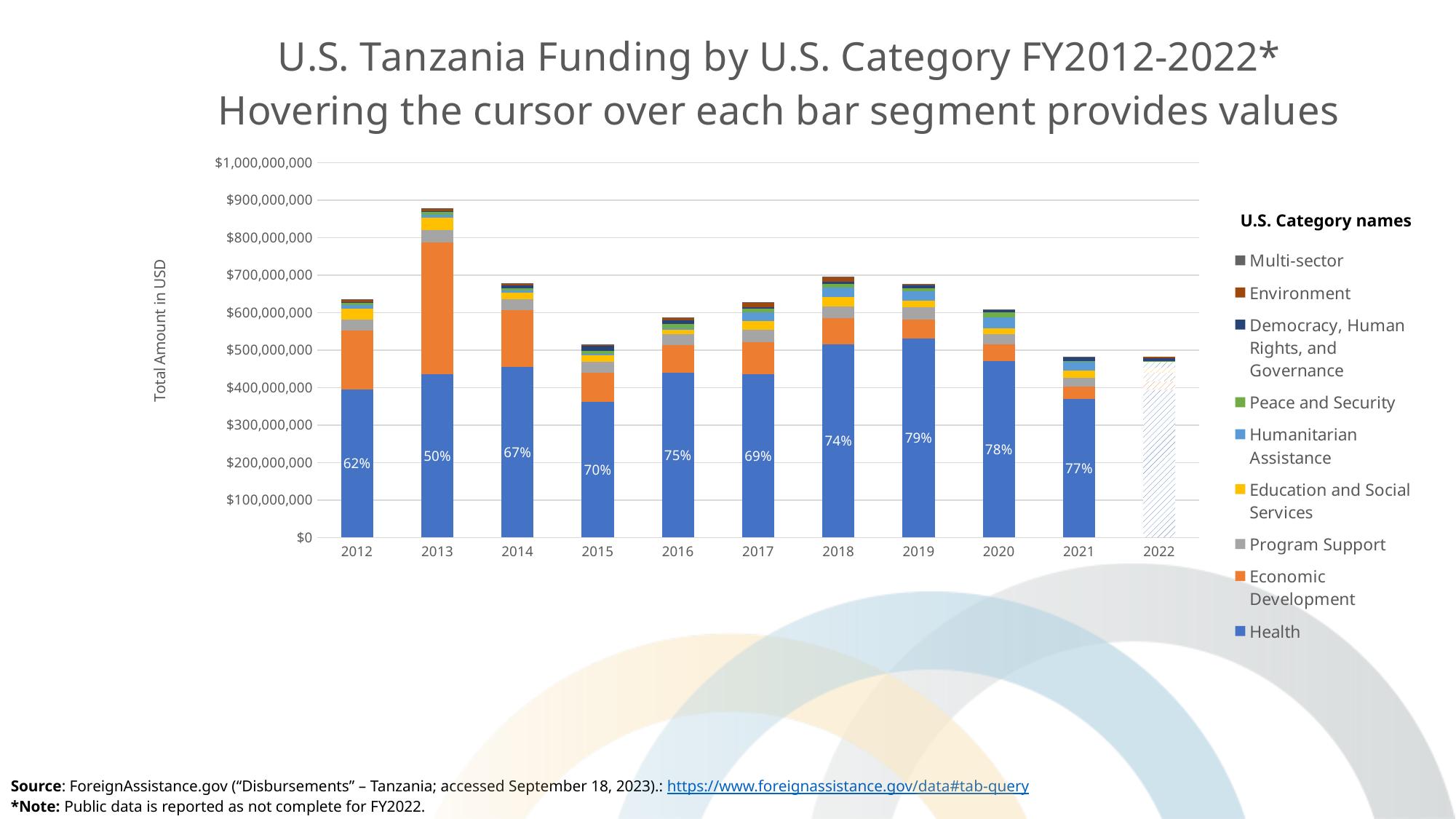
By how many percentage points does the Health label for 2019 exceed the Health label for 2013? 29 percentage points What kind of chart is shown on the slide? Stacked bar chart How many fiscal years are shown along the x axis? 11 Which year has the lowest Health percentage label? 2013 Which year has a larger total bar, 2012 or 2013? 2013 What percentage label is printed on the Health segment for 2013? 50% How many U.S. category names does the legend list? 9 Is the total bar for 2013 greater or less than $800,000,000? greater What percentage label is printed on the Health segment for 2019? 79% Is the total bar for 2015 greater or less than $600,000,000? less Which year has the tallest total bar? 2013 Which category is shown in blue at the bottom of each bar? Health